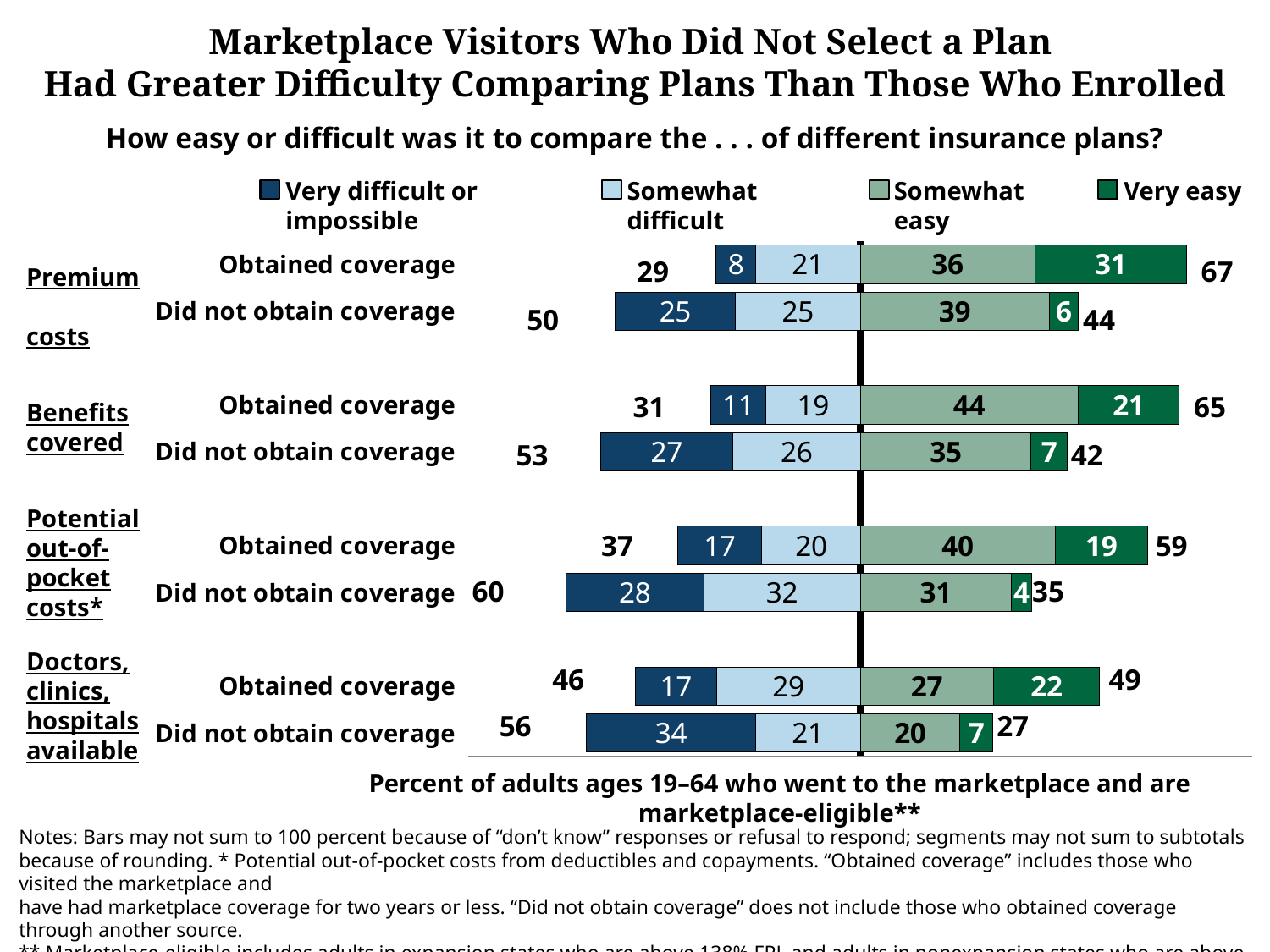
How many bars are plotted on the chart? 8 For Potential out-of-pocket costs, what is the combined 'Very difficult or impossible' plus 'Somewhat difficult' total for those who did not obtain coverage? 60 Which bar has the lowest 'Very easy' value? Potential out-of-pocket costs, Did not obtain coverage For Doctors, clinics, hospitals available, what is the combined easy subtotal shown for those who obtained coverage? 49 How many series does the legend list? 4 For Benefits covered, what is the 'Somewhat easy' value for those who obtained coverage? 44 What kind of chart is shown on the slide? Stacked bar chart For Premium costs, what percentage of those who obtained coverage said comparing plans was very easy? 31 Which bar has the highest 'Very easy' value? Premium costs, Obtained coverage For Doctors, clinics, hospitals available, what percentage of those who did not obtain coverage said it was very difficult or impossible? 34 For Benefits covered, which group has the larger 'Very difficult or impossible' value: obtained coverage or did not obtain coverage? Did not obtain coverage For Premium costs, what is the difference between the 'Very easy' values for those who obtained coverage and those who did not? 25